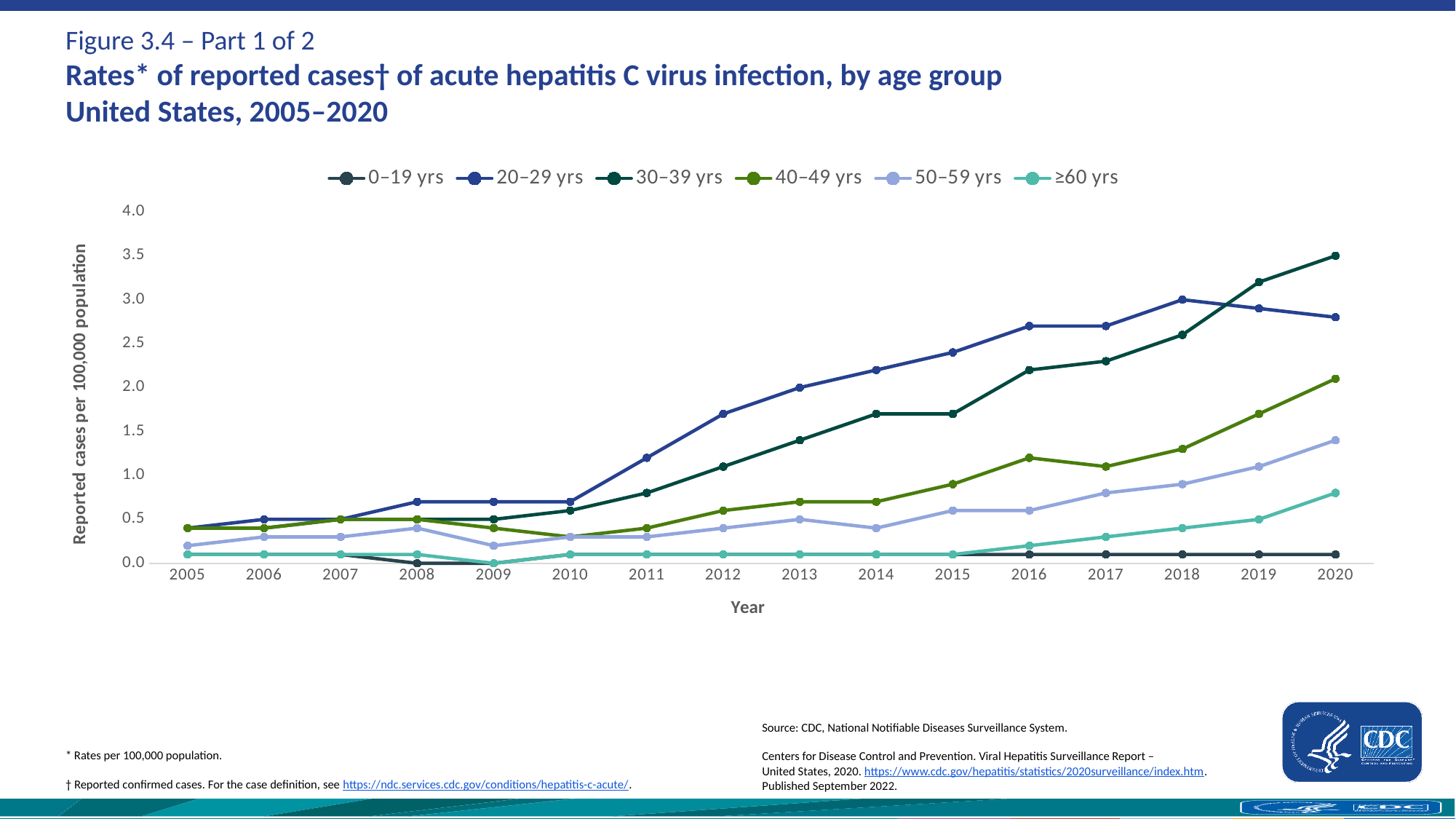
In 2018, which is larger: the rate for 20–29 yrs or the rate for 30–39 yrs? 20–29 yrs What kind of chart is shown on the slide? line chart How many years are shown along the x axis? 16 What is the label of the y axis? Reported cases per 100,000 population Is the value for 20–29 yrs in 2020 greater or less than 3.0? less Which age group has the lowest rate in 2020? 0–19 yrs Which age group has the highest rate in 2015? 20–29 yrs Which age group has the highest rate in 2020? 30–39 yrs How many age-group series does the legend list? 6 Is the value for ≥60 yrs in 2020 greater or less than 1.0? less Does the rate for 30–39 yrs rise or fall from 2010 to 2020? rises Is the value for 30–39 yrs in 2020 greater or less than 3.0? greater